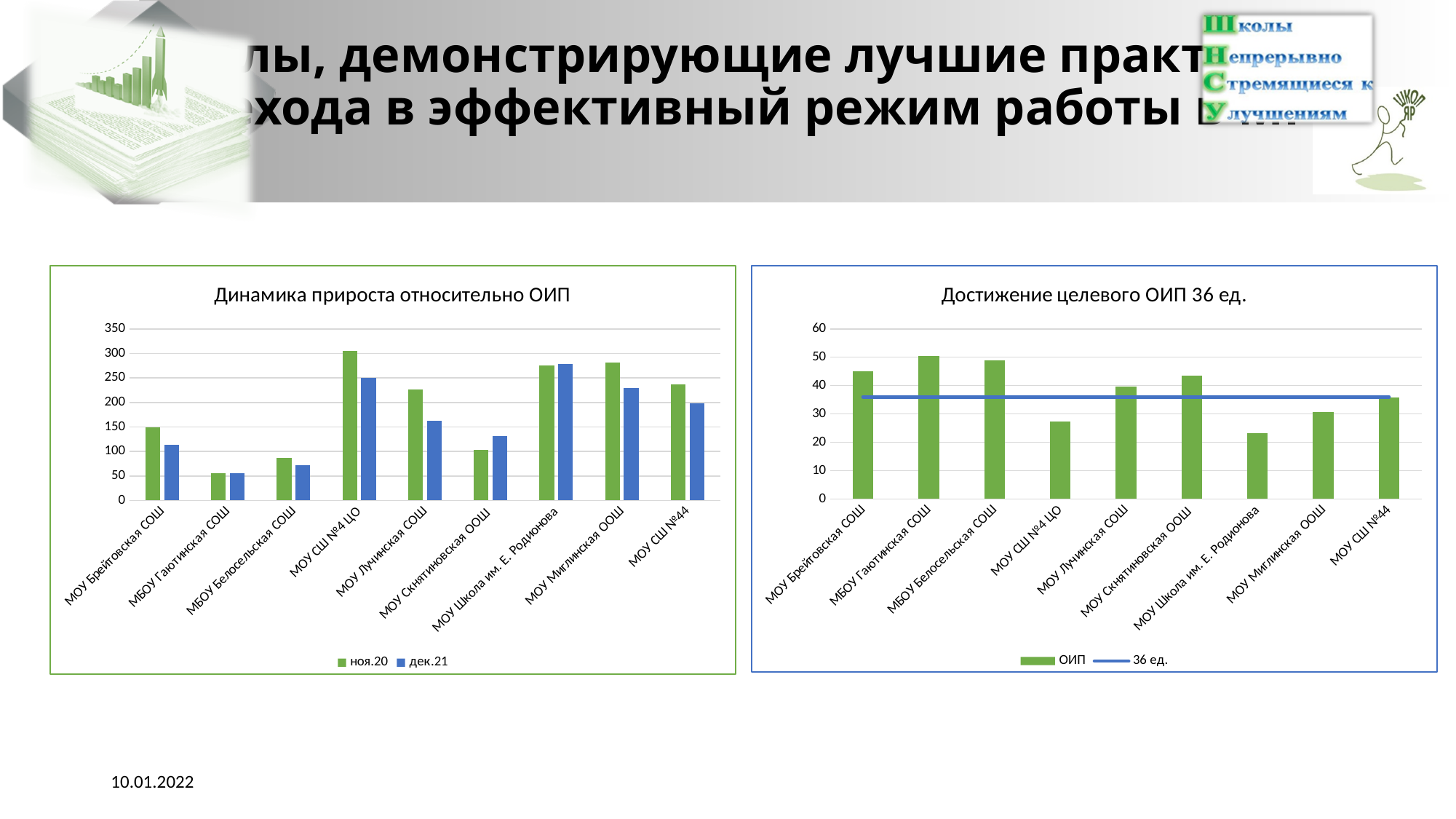
In the left chart "Динамика прироста относительно ОИП", which school has the lowest ноя.20 value? МБОУ Гаютинская СОШ What is the title of the right chart? Достижение целевого ОИП 36 ед. In the left chart "Динамика прироста относительно ОИП", how many series does the legend list? 2 In the right chart "Достижение целевого ОИП 36 ед.", how many entries does the legend list? 2 In the right chart "Достижение целевого ОИП 36 ед.", is the ОИП value for МОУ СШ №4 ЦО greater or less than 30? less In the left chart "Динамика прироста относительно ОИП", which is larger for МОУ Миглинская ООШ: the ноя.20 value or the дек.21 value? ноя.20 In the left chart "Динамика прироста относительно ОИП", is the дек.21 value for МОУ Брейтовская СОШ greater or less than 100? greater In the left chart "Динамика прироста относительно ОИП", which school has the highest ноя.20 value? МОУ СШ №4 ЦО In the right chart "Достижение целевого ОИП 36 ед.", which school has the lowest ОИП value? МОУ Школа им. Е. Родионова What kind of chart is the left chart titled "Динамика прироста относительно ОИП"? bar chart In the left chart "Динамика прироста относительно ОИП", is the ноя.20 value for МОУ СШ №4 ЦО greater or less than 250? greater In the left chart "Динамика прироста относительно ОИП", how many schools are shown on the x axis? 9